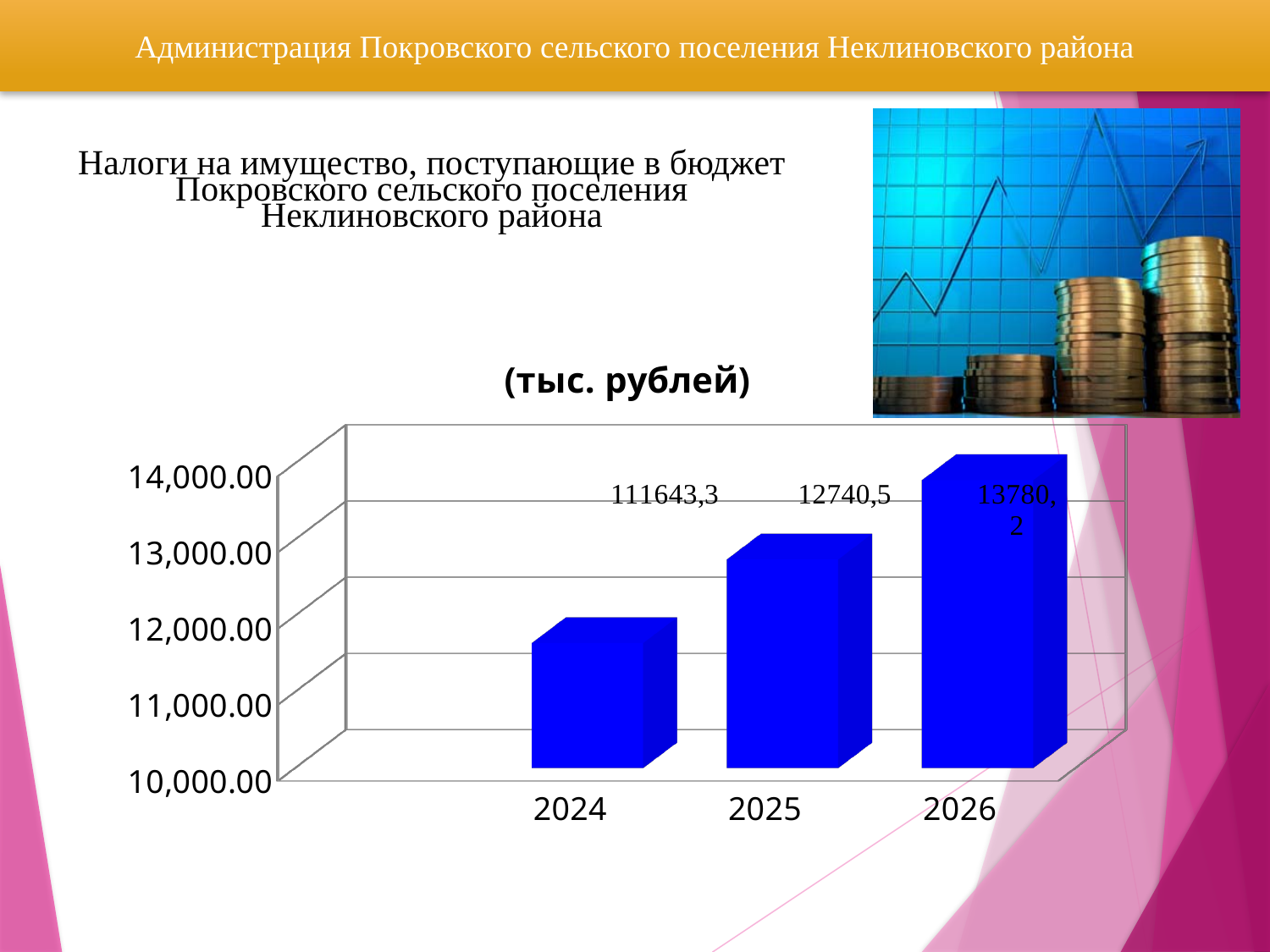
Which year has the highest value in the chart? 2026 Do the values rise or fall from 2024 to 2026? rise Which is larger, the value for 2025 or the value for 2026? 2026 What unit is given in the chart title above the bars? (тыс. рублей) What is the difference between the labelled values for 2026 and 2025? 1039,7 Is the value for 2026 greater or less than 13,000.00? greater Is the value for 2024 greater or less than 12,000.00? less Which year has the lowest value in the chart? 2024 What is the value labelled for 2026? 13780,2 What is the value labelled for 2025? 12740,5 How many years (categories) are shown on the x axis of the chart? 3 What kind of chart is shown on the slide? bar chart